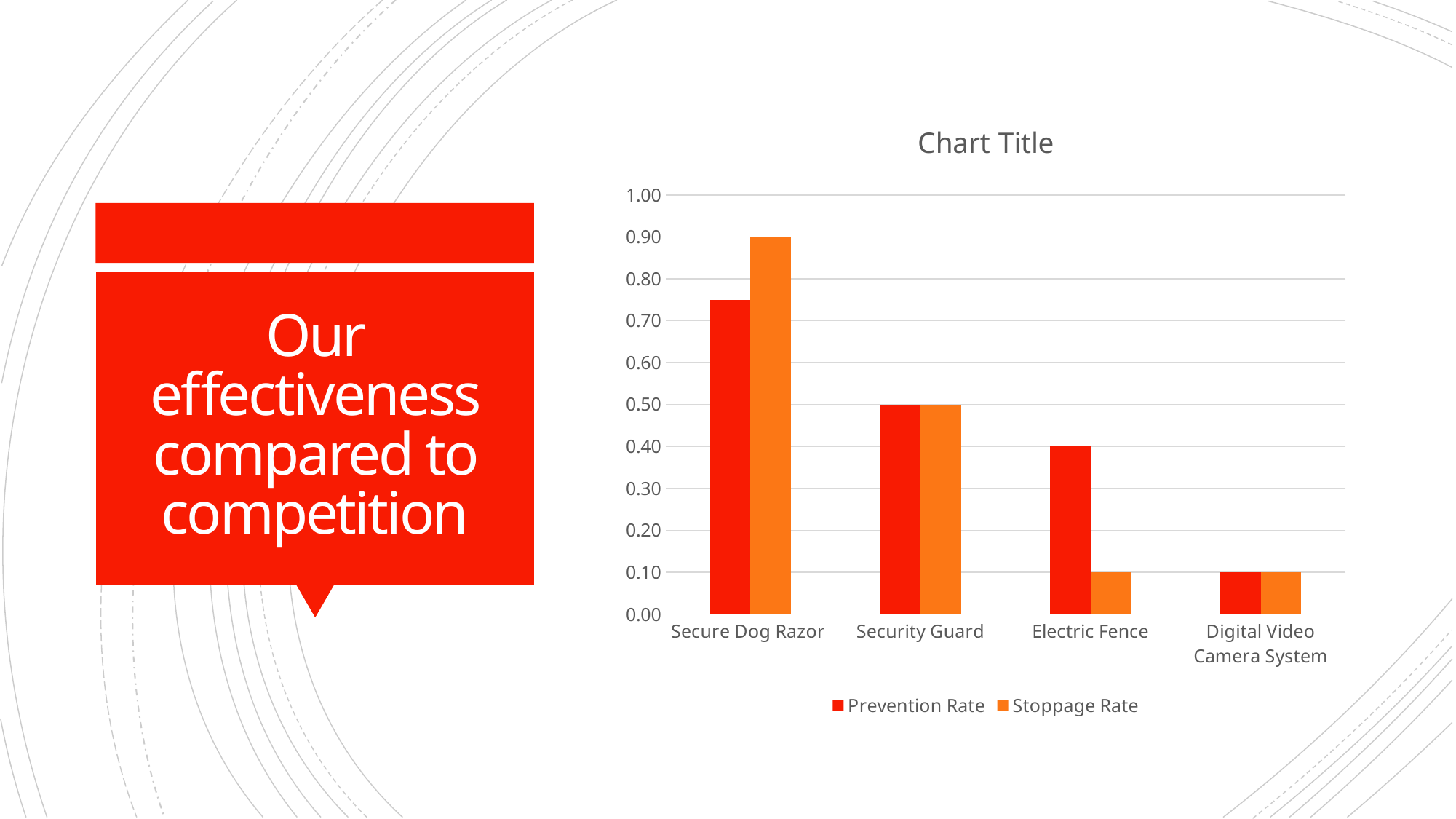
Which category has the highest Stoppage Rate? Secure Dog Razor Which category has the lowest Prevention Rate? Digital Video Camera System How many series does the legend list? 2 Is the Prevention Rate for Secure Dog Razor greater or less than 0.70? greater What is the Prevention Rate for Security Guard? 0.50 What is the Stoppage Rate for Digital Video Camera System? 0.10 What is the Prevention Rate for Electric Fence? 0.40 What is the difference between the Prevention Rate and the Stoppage Rate for Electric Fence? 0.30 What kind of chart is shown on the slide? bar chart Which series is shown in orange in the legend? Stoppage Rate What is the Stoppage Rate for Secure Dog Razor? 0.90 How many categories are shown on the x axis? 4